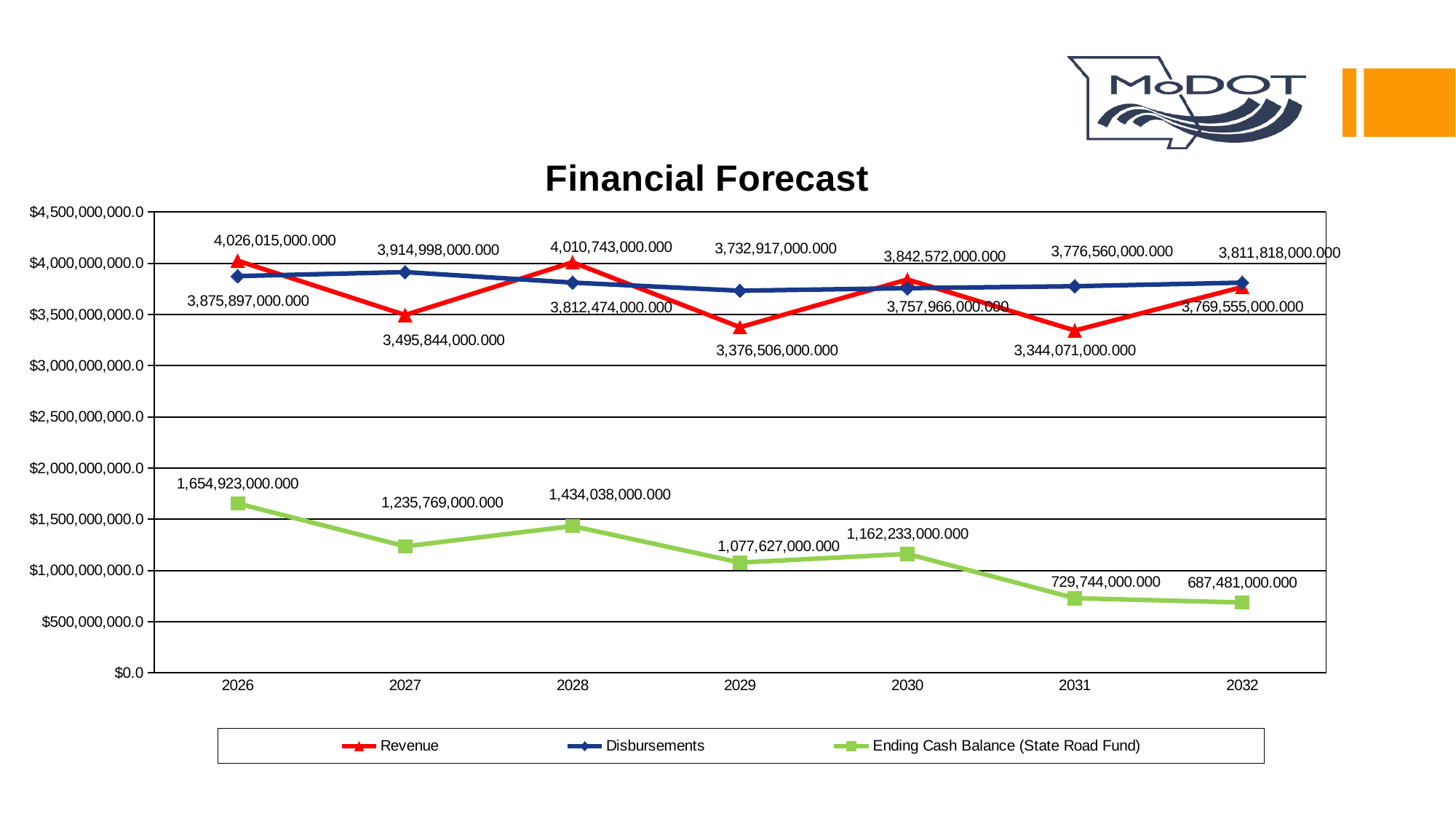
Does the Ending Cash Balance (State Road Fund) overall rise or fall from 2026 to 2032? Fall What is the Disbursements value for 2029? 3,732,917,000.000 What is the title of the chart? Financial Forecast How many years are shown on the x axis? 7 What is the Ending Cash Balance (State Road Fund) value for 2032? 687,481,000.000 How many series does the legend list? 3 What is the difference between Revenue and Disbursements in 2026? 150,118,000.000 What is the Revenue value for 2026? 4,026,015,000.000 In 2027, which is larger: Revenue or Disbursements? Disbursements In which year is Revenue lowest? 2031 In which year is the Ending Cash Balance (State Road Fund) highest? 2026 What kind of chart is shown on the slide? Line chart